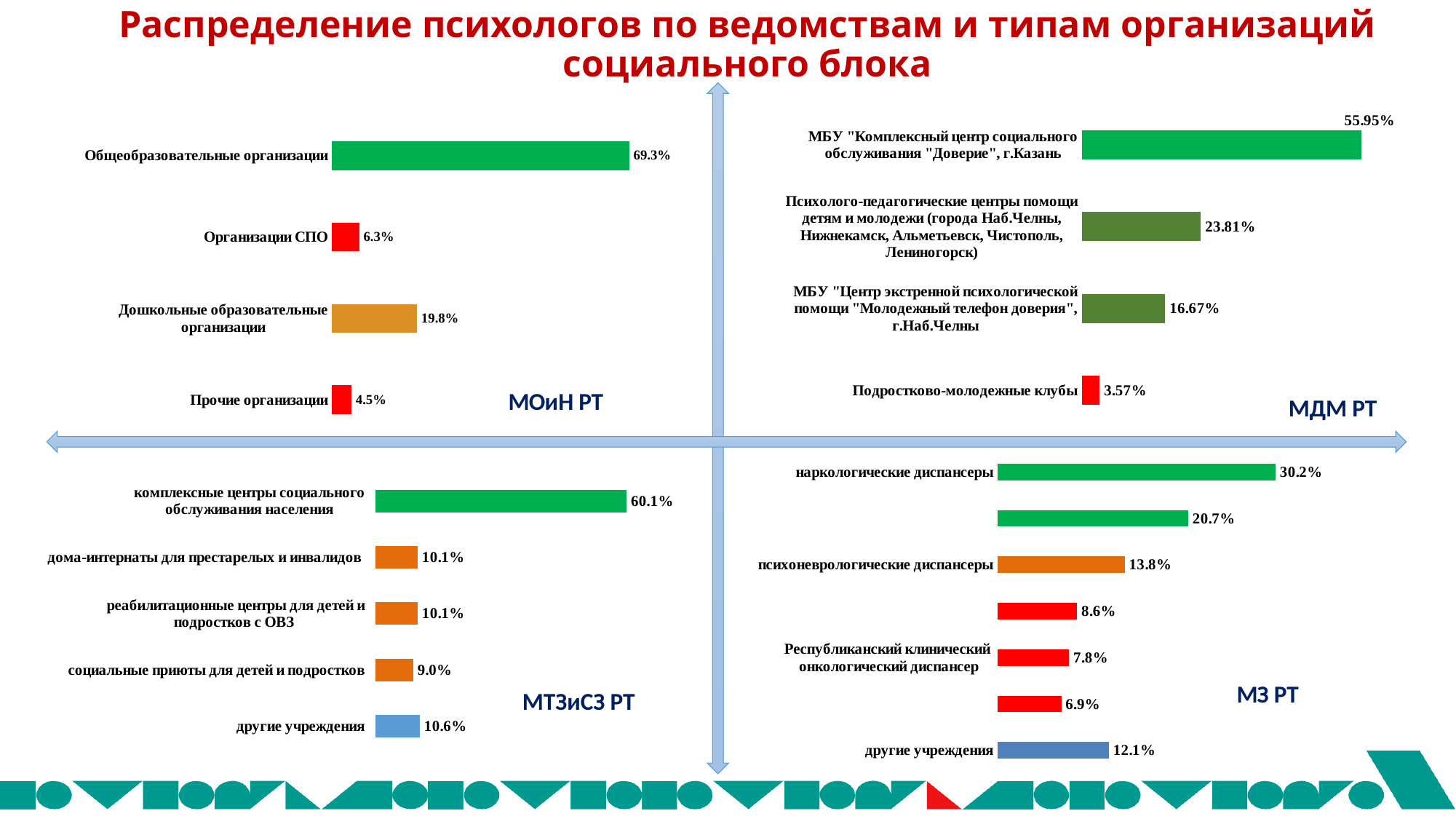
In the МТЗиСЗ РТ chart (bottom-left), what is the value for другие учреждения? 10.6% In the МОиН РТ chart (top-left), what is the value for Общеобразовательные организации? 69.3% In the МДМ РТ chart (top-right), which category has the highest value? МБУ "Комплексный центр социального обслуживания "Доверие", г.Казань How many categories are shown in the МДМ РТ chart (top-right)? 4 In the МТЗиСЗ РТ chart (bottom-left), which is larger: дома-интернаты для престарелых и инвалидов or социальные приюты для детей и подростков? дома-интернаты для престарелых и инвалидов In the МЗ РТ chart (bottom-right), what is the value for наркологические диспансеры? 30.2% How many categories are shown in the МТЗиСЗ РТ chart (bottom-left)? 5 In the МДМ РТ chart (top-right), what is the value for Подростково-молодежные клубы? 3.57% What type of chart is used in the МОиН РТ quadrant (top-left)? Bar chart In the МЗ РТ chart (bottom-right), what is the difference between психоневрологические диспансеры and другие учреждения? 1.7% In the МОиН РТ chart (top-left), which category has the lowest value? Прочие организации In the МОиН РТ chart (top-left), what is the difference between Дошкольные образовательные организации and Организации СПО? 13.5%